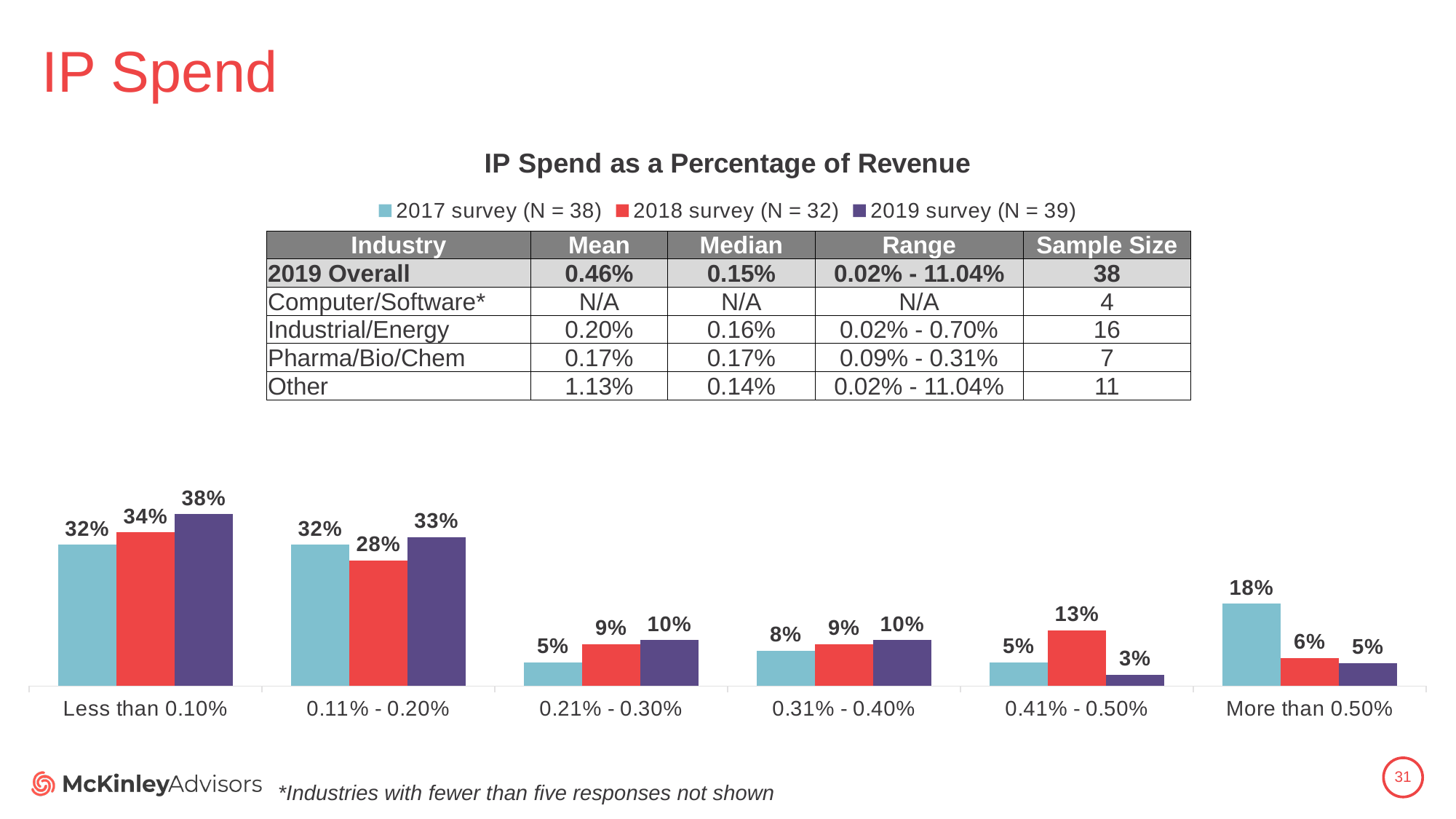
What is the value for the 2018 survey in the '0.41% - 0.50%' category? 13% What is the sample size for the 2018 survey according to the legend? N = 32 How many series does the chart legend list? 3 What is the title of the chart? IP Spend as a Percentage of Revenue What is the difference between the 2017 survey and 2018 survey values in the 'More than 0.50%' category? 12% What is the value for the 2019 survey in the 'Less than 0.10%' category? 38% Which category has the highest value for the 2019 survey? Less than 0.10% What is the value for the 2017 survey in the 'More than 0.50%' category? 18% What kind of chart is shown on the slide? Bar chart Which category has the lowest value for the 2019 survey? 0.41% - 0.50% Which is larger in the '0.11% - 0.20%' category: the 2017 survey value or the 2018 survey value? 2017 survey How many categories are shown on the x axis of the chart? 6